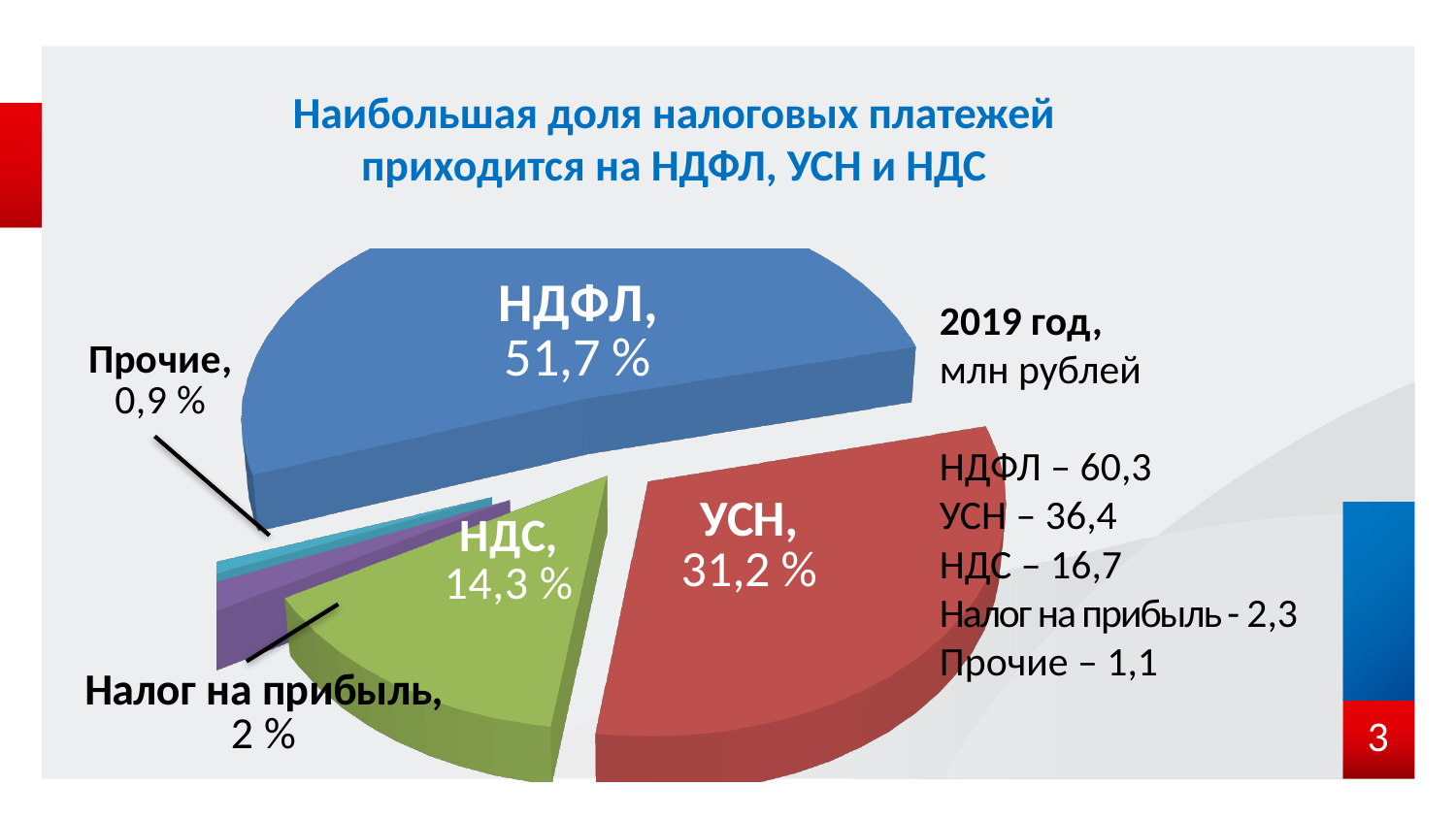
What share of the pie does НДС have? 14,3 % How many slices does the pie chart have? 5 Which slice of the pie is the largest? НДФЛ What is the difference in percentage points between the НДФЛ share and the УСН share? 20,5 Which slice of the pie is the smallest? Прочие What kind of chart is shown on the slide? Pie chart What colour is the НДФЛ slice of the pie? Blue Which is larger, the share for УСН or the share for НДС? УСН What share of the pie does НДФЛ have? 51,7 % What share of the pie does Прочие have? 0,9 %